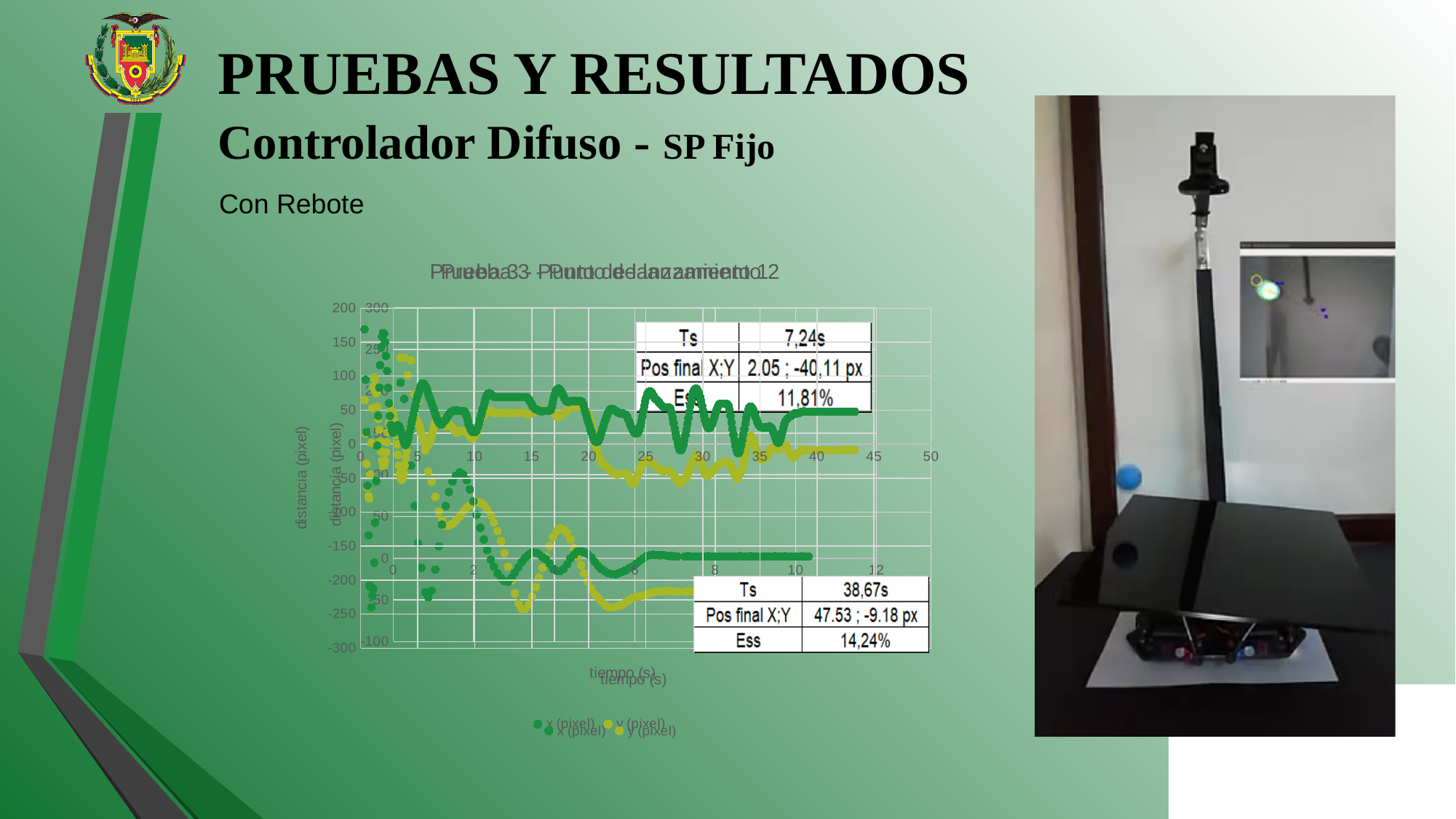
How many series does the chart legend list? 2 In the lower table overlaid on the chart, what is the value of Ts? 38,67s Which of the two tables on the chart reports the larger Ts value, the upper or the lower one? the lower one (38,67s) In the upper table overlaid on the chart, what is the value of Ts? 7,24s In the upper table overlaid on the chart, what is the value of Ess? 11,81% In the upper table overlaid on the chart, what is the Pos final X;Y? 2.05 ; -40,11 px In the lower table overlaid on the chart, what is the value of Ess? 14,24% Which of the two tables on the chart reports the larger Ess value, the upper or the lower one? the lower one (14,24%) What is the label of the chart's horizontal axis? tiempo (s) What kind of chart is shown on the slide? scatter chart What are the two series named in the chart legend? x (pixel) and y (pixel) In the lower table overlaid on the chart, what is the Pos final X;Y? 47.53 ; -9.18 px